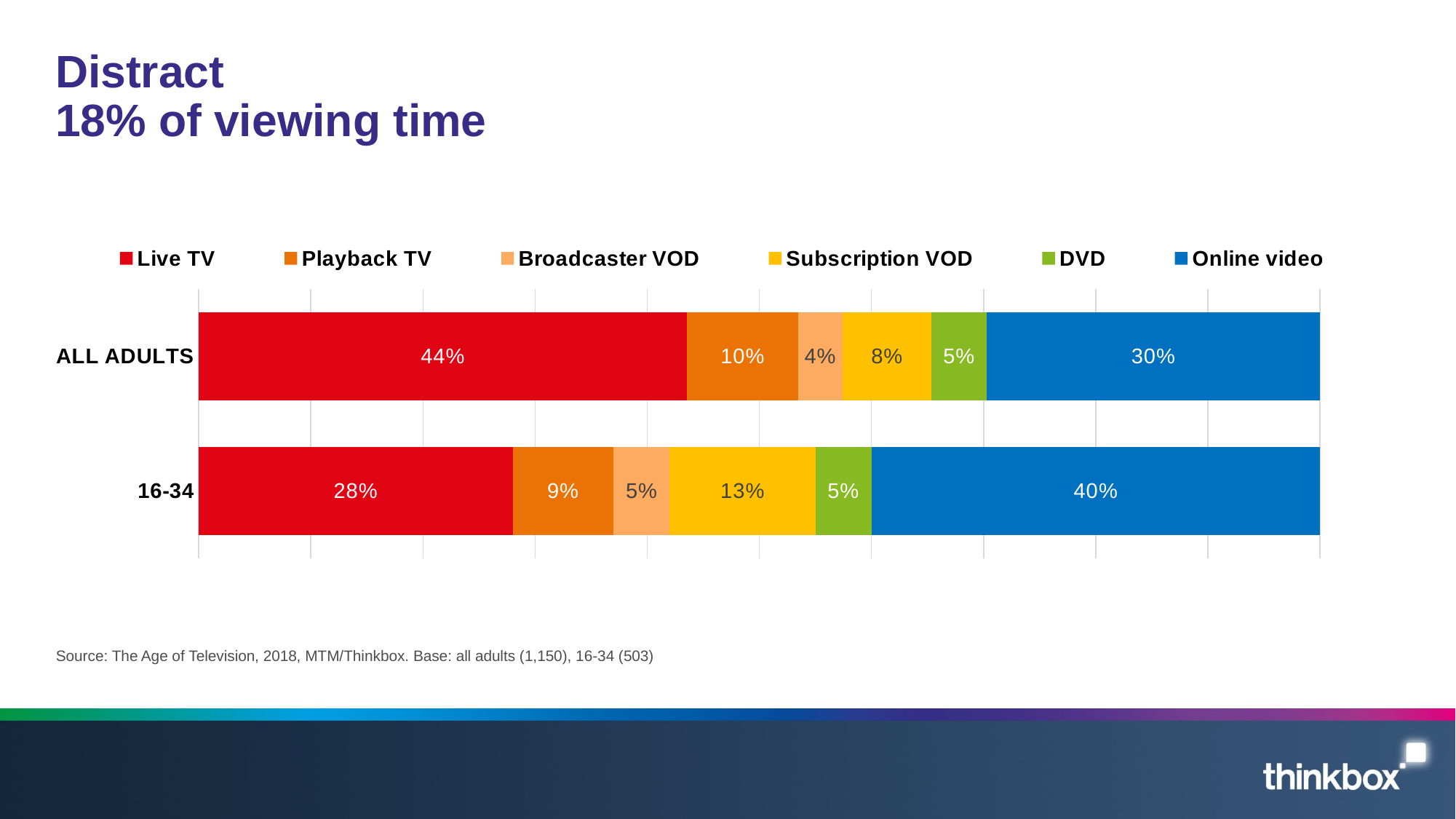
Which category has the largest share of viewing time for the 16-34 group? Online video What type of chart is shown on the slide? Stacked bar chart Which group has a higher Online video share, ALL ADULTS or 16-34? 16-34 What is the Subscription VOD share for the 16-34 group? 13% Which category has the smallest share of viewing time for ALL ADULTS? Broadcaster VOD What percentage of viewing time is Online video for the 16-34 group? 40% How many groups (bars) are shown in the chart? 2 What percentage of viewing time is Live TV for ALL ADULTS? 44% Which category has the largest share of viewing time for ALL ADULTS? Live TV What is the difference between the Live TV share for ALL ADULTS and for 16-34? 16 percentage points How many series does the legend list? 6 What is the Broadcaster VOD value for ALL ADULTS? 4%